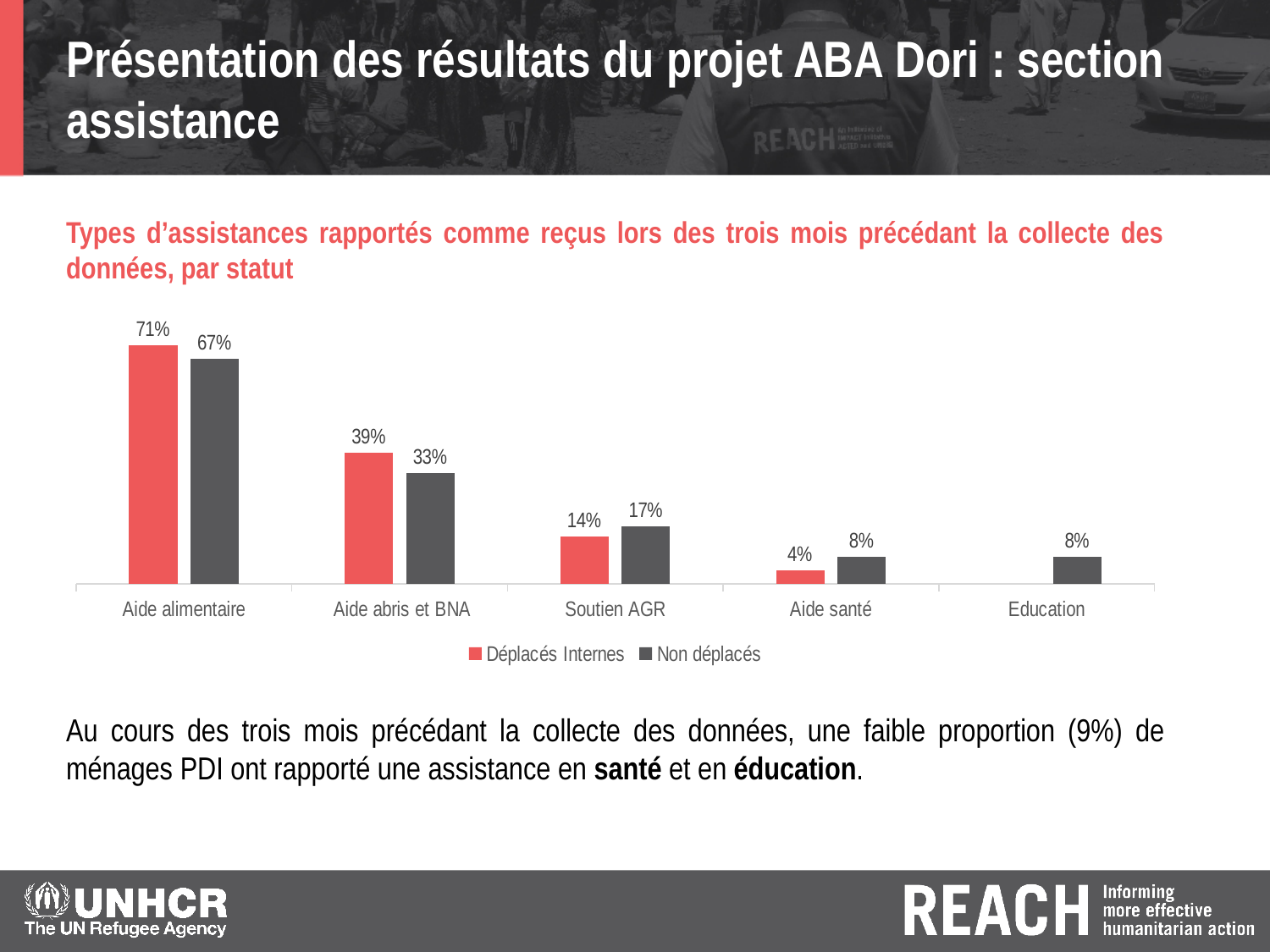
What is the difference between Déplacés Internes and Non déplacés for Aide abris et BNA? 6 percentage points Do the Non déplacés values rise or fall from Aide alimentaire to Aide santé along the x axis? Fall What percentage of Déplacés Internes reported receiving Aide alimentaire? 71% Which colour represents the Déplacés Internes series in the legend? Red What is the value for Déplacés Internes in the Aide santé category? 4% What kind of chart is shown on the slide? Bar chart How many assistance categories are shown on the x axis? 5 How many series does the legend list? 2 Which category has the highest value for Non déplacés? Aide alimentaire For Soutien AGR, which series has the larger value: Déplacés Internes or Non déplacés? Non déplacés What is the value for Non déplacés in the Soutien AGR category? 17% Which category has the lowest value for Déplacés Internes among those with a labelled bar? Aide santé